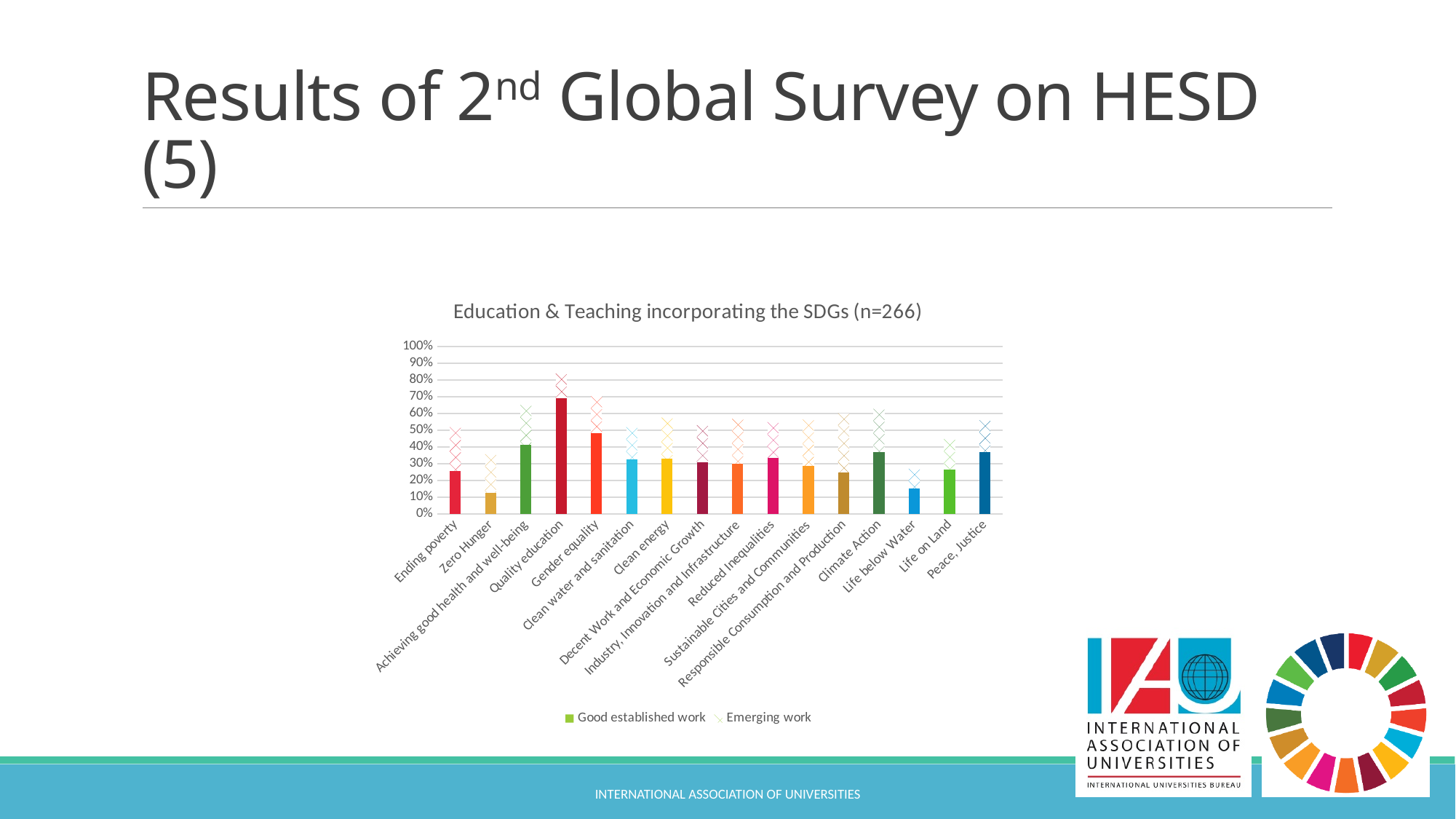
Which has the larger Good established work value, Climate Action or Life below Water? Climate Action Which category has the lowest value for Good established work? Zero Hunger Is the Good established work value for Quality education greater or less than 60%? greater How many series does the legend list? 2 Is the Good established work value for Life below Water greater or less than 20%? less Is the Good established work value for Gender equality greater or less than 40%? greater What are the two series named in the legend? Good established work; Emerging work Which category has the lowest combined (stacked) total of Good established work and Emerging work? Life below Water Which category has the highest value for Good established work? Quality education How many SDG categories are shown on the x axis? 16 What kind of chart is shown on the slide? Stacked bar chart What is the title of the chart? Education & Teaching incorporating the SDGs (n=266)